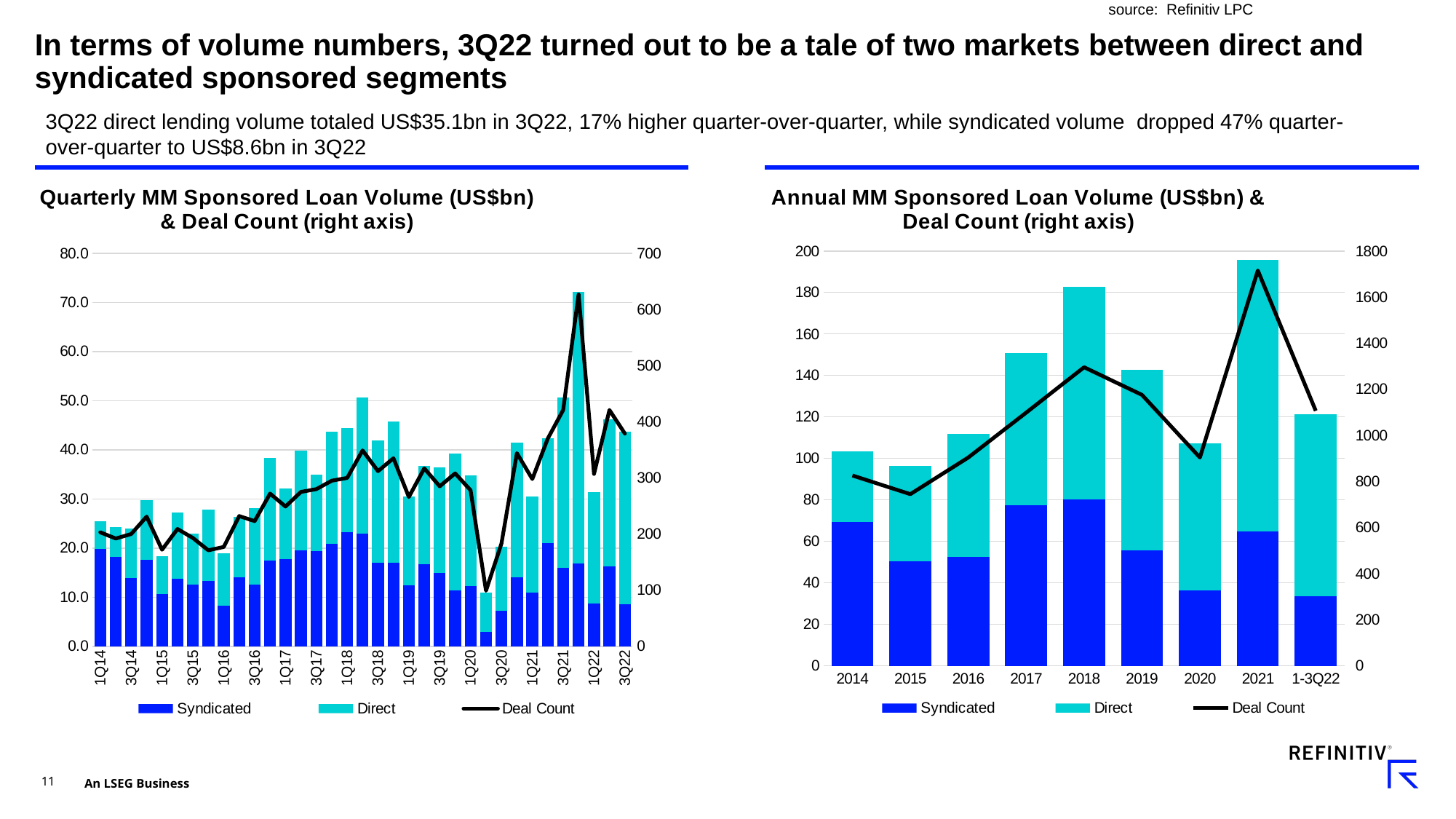
How many series does the legend of the Quarterly MM Sponsored Loan Volume chart list? 3 In the Annual MM Sponsored Loan Volume chart, which is larger, the total volume for 2018 or for 2019? 2018 In the Quarterly MM Sponsored Loan Volume chart, which quarter has the tallest stacked bar? 4Q21 In the Annual MM Sponsored Loan Volume chart, which year has the shortest stacked bar (lowest total volume)? 2015 In the Annual MM Sponsored Loan Volume chart, which year has the tallest stacked bar (highest total volume)? 2021 In the Annual MM Sponsored Loan Volume chart, is the total volume for 2020 greater or less than 120? less What kind of chart is the Quarterly MM Sponsored Loan Volume chart? Stacked bar chart with a line for Deal Count In the Annual MM Sponsored Loan Volume chart, does the Deal Count line rise or fall from 2015 to 2018? rise In the Annual MM Sponsored Loan Volume chart, in which year does the Deal Count line reach its peak? 2021 In the Annual MM Sponsored Loan Volume chart, how many categories are shown on the x axis? 9 In the Annual MM Sponsored Loan Volume chart, is the total volume for 2021 greater or less than 180? greater